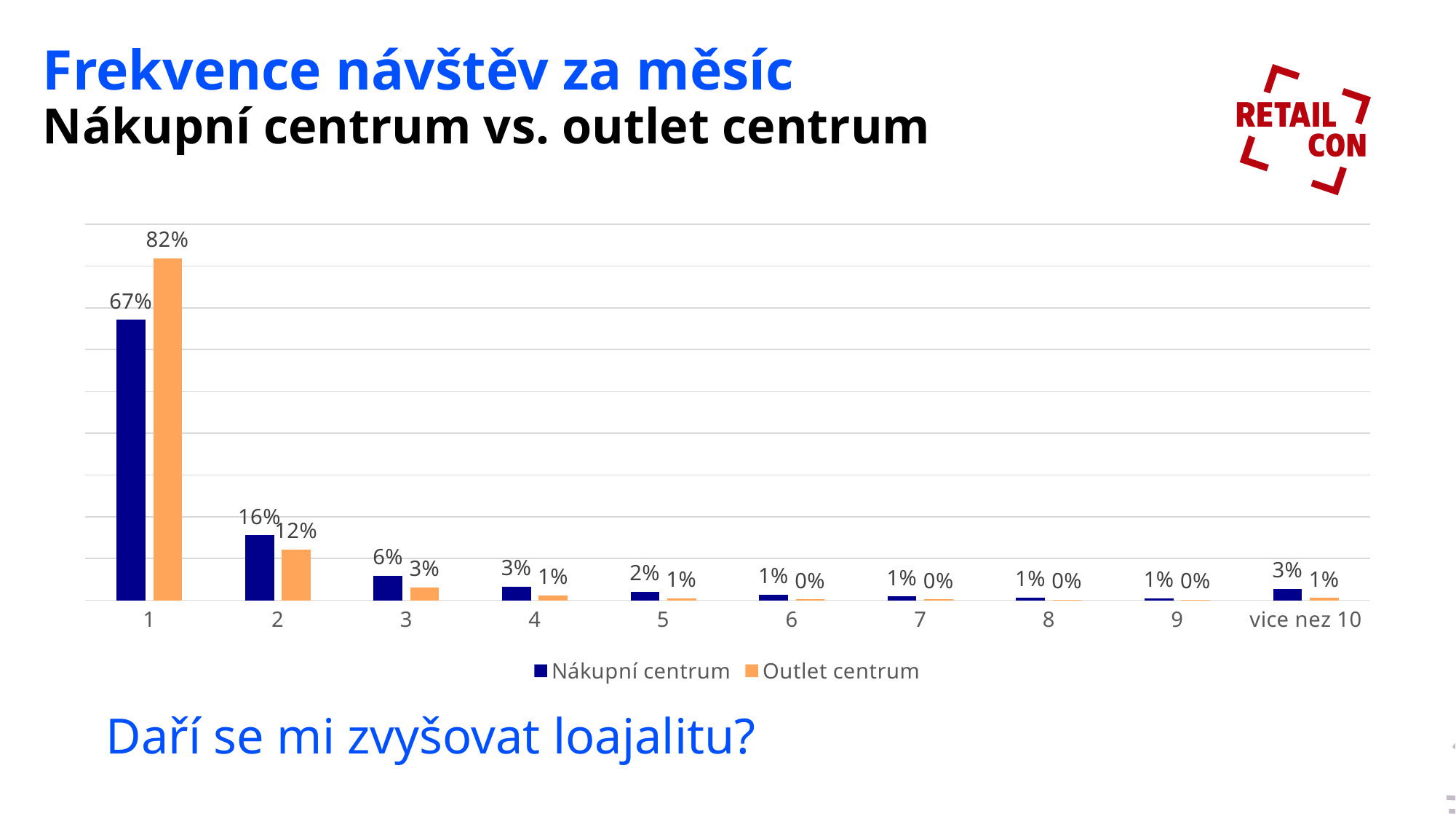
What kind of chart is shown on the slide? bar chart What is the value for Nákupní centrum at category 1? 67% What is the value for Outlet centrum at category 3? 3% What is the value for Outlet centrum at category 1? 82% What is the value for Nákupní centrum at 'vice nez 10'? 3% How many categories are shown on the x axis? 10 What is the difference between Nákupní centrum and Outlet centrum at category 2? 4% What is the difference between Outlet centrum and Nákupní centrum at category 1? 15% How many series does the legend list? 2 What is the value for Nákupní centrum at category 2? 16% Which is larger at category 2: Nákupní centrum or Outlet centrum? Nákupní centrum Which category has the highest value for Outlet centrum? 1